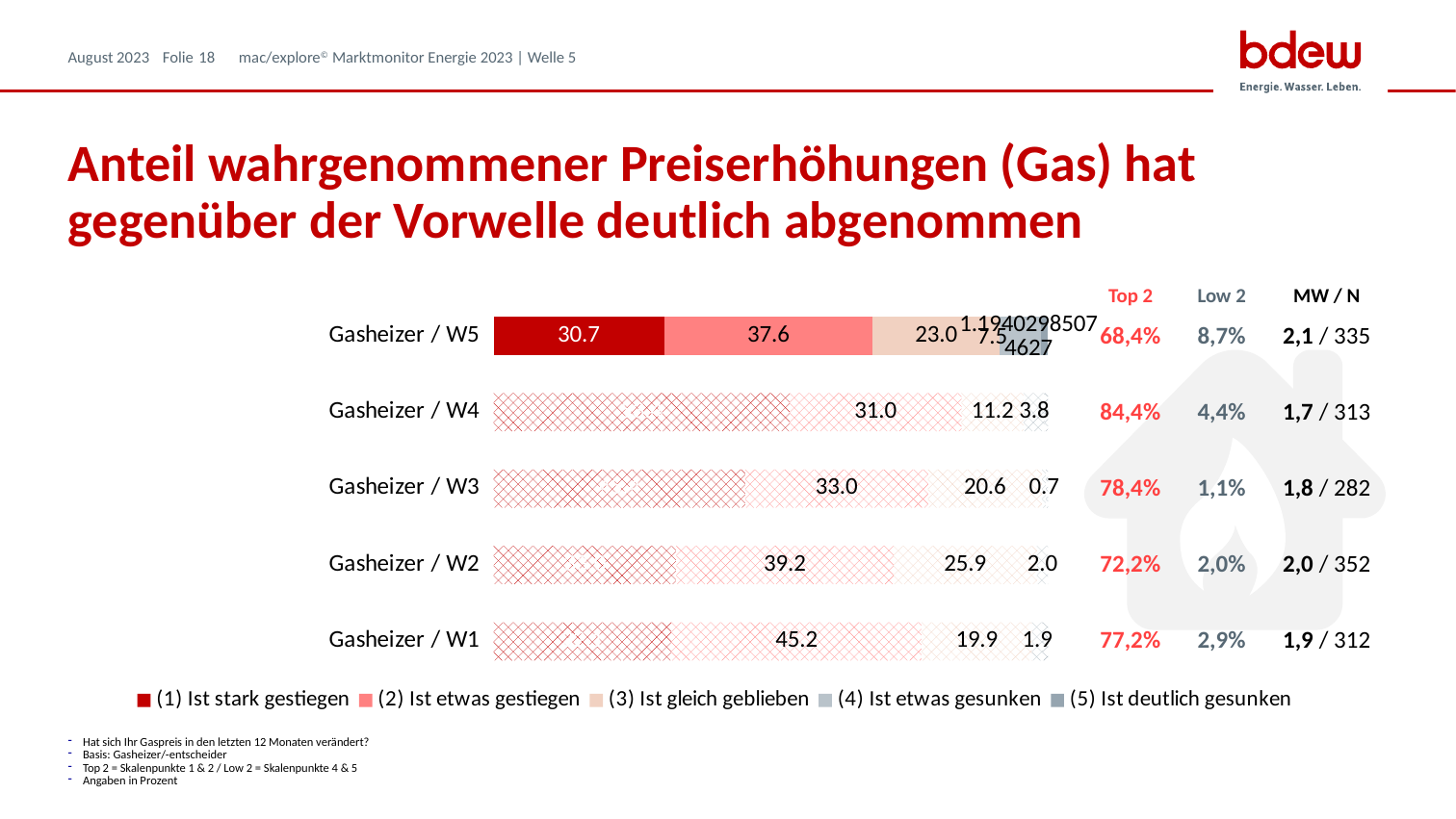
How many categories (waves) are plotted in the chart? 5 What is the value for "(2) Ist etwas gestiegen" in the Gasheizer / W5 bar? 37.6 What is the value for "(1) Ist stark gestiegen" in the Gasheizer / W5 bar? 30.7 What is the value for "(3) Ist gleich geblieben" in the Gasheizer / W5 bar? 23.0 What is the Low 2 value for Gasheizer / W5? 8,7% In the Gasheizer / W5 bar, what is the difference between "(2) Ist etwas gestiegen" and "(1) Ist stark gestiegen"? 6.9 What kind of chart is shown on the slide? bar chart In the Gasheizer / W5 bar, which is larger: "(1) Ist stark gestiegen" or "(2) Ist etwas gestiegen"? (2) Ist etwas gestiegen Which wave has the lowest Top 2 value? Gasheizer / W5 What is the first entry in the chart's legend? (1) Ist stark gestiegen Which wave has the highest Top 2 value? Gasheizer / W4 How many series does the legend list? 5